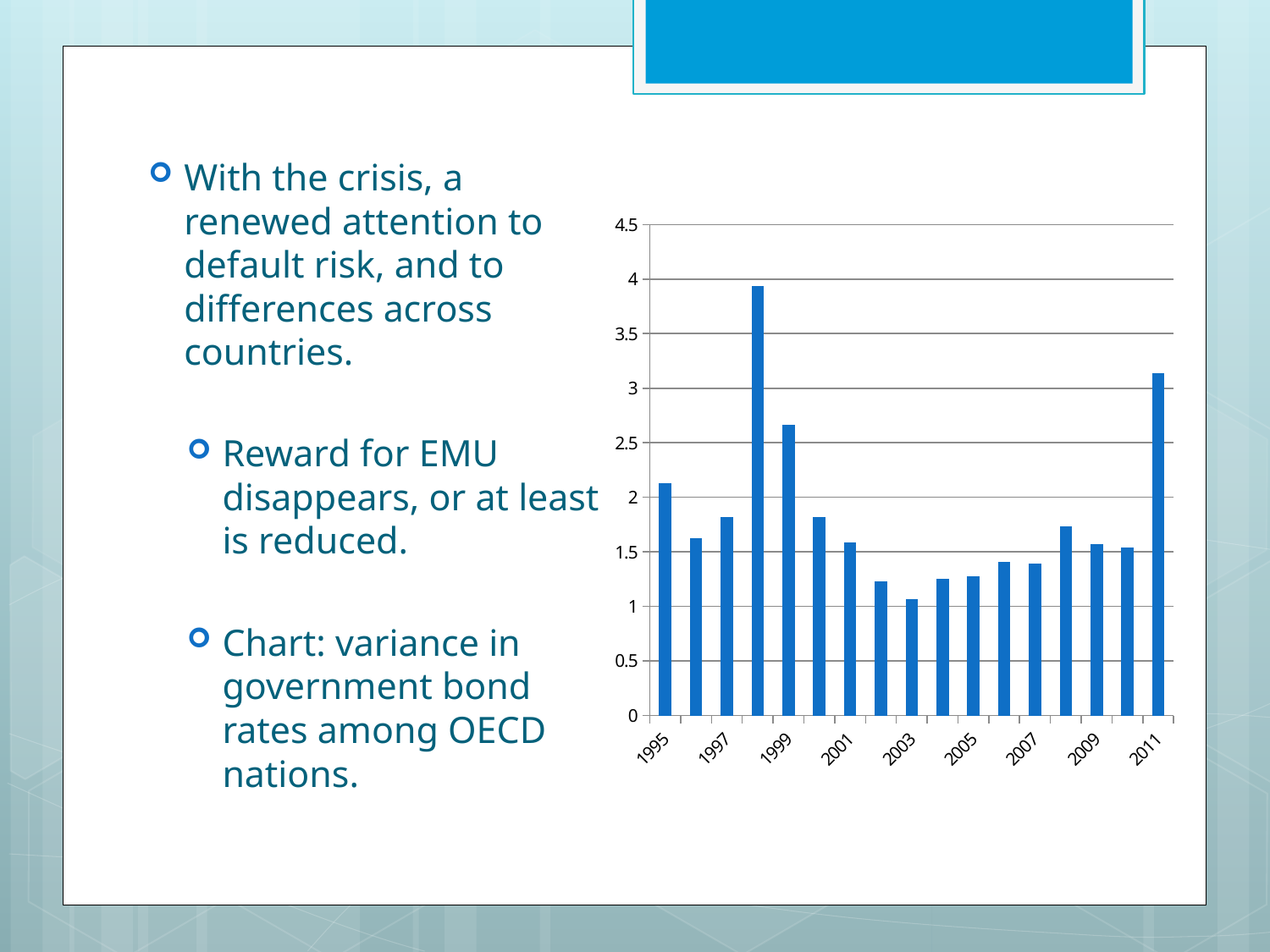
What kind of chart is shown on the slide? bar chart Which has the larger value, 1999 or 2001? 1999 Is the value for 2003 greater or less than 1.5? less Is the value for 2011 greater or less than 2.5? greater Which labelled year on the x axis has the lowest value in the chart? 2003 Is the value for 1999 greater or less than 2.5? greater How many bars are plotted in the chart? 17 What is the highest value shown on the chart's vertical axis? 4.5 Do the values rise or fall from 1999 to 2003? fall Which has the larger value, 2011 or 1995? 2011